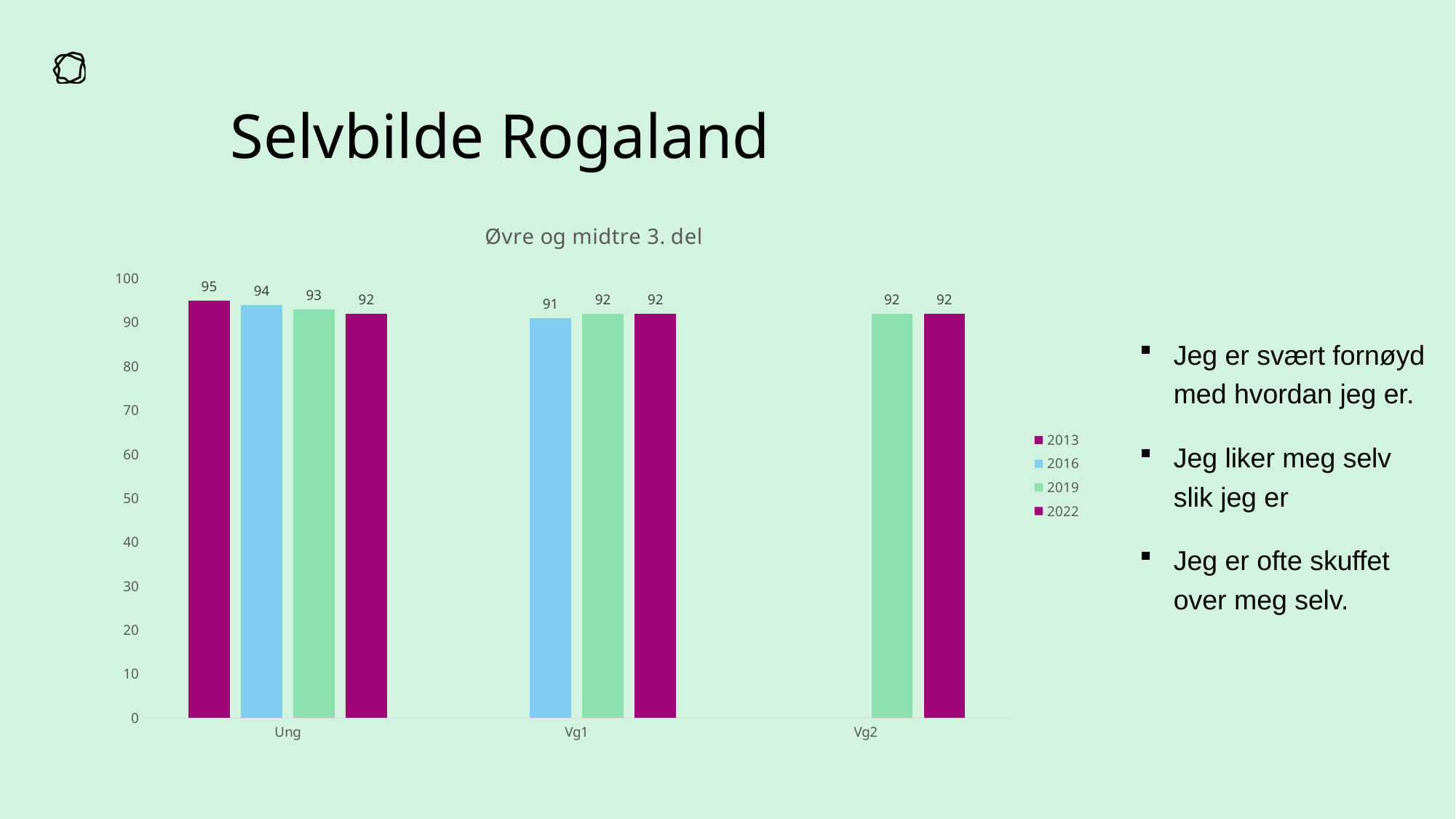
What is the difference between the 2013 and 2022 values in the Ung category? 3 What kind of chart is shown on the slide? bar chart How many categories are shown on the x axis? 3 How many series does the legend list? 4 Which year has the highest value in the Ung category? 2013 What is the value for 2022 in the Vg2 category? 92 Which year has the lowest value in the Vg1 category? 2016 What is the title of the chart? Øvre og midtre 3. del What is the value for 2013 in the Ung category? 95 What is the value for 2019 in the Ung category? 93 What is the value for 2016 in the Vg1 category? 91 Which is larger: the 2016 value for Ung or the 2016 value for Vg1? Ung